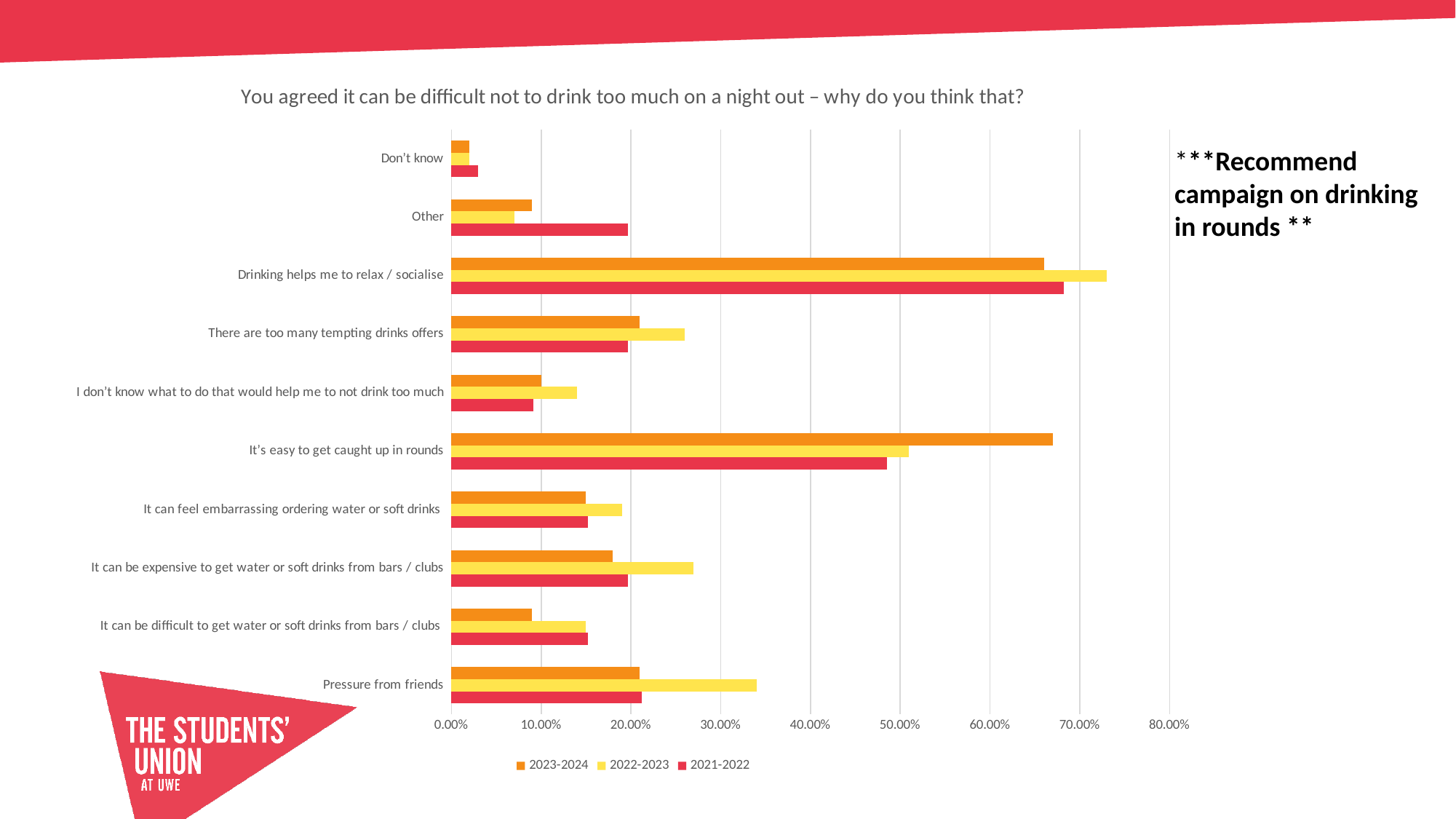
What kind of chart is shown on the slide? Bar chart How many series does the chart legend list? 3 How many categories (reasons) are plotted on the chart? 10 Is the 2023-2024 value for 'It's easy to get caught up in rounds' greater or less than 60%? greater Is the 2022-2023 value for 'Pressure from friends' greater or less than 30%? greater For 'It's easy to get caught up in rounds', which series has the larger value: 2023-2024 or 2021-2022? 2023-2024 Is the 2023-2024 value for 'It can be difficult to get water or soft drinks from bars / clubs' greater or less than 20%? less Which category has the highest value for the 2022-2023 series? Drinking helps me to relax / socialise Which category has the highest value for the 2021-2022 series? Drinking helps me to relax / socialise What is the title of the chart? You agreed it can be difficult not to drink too much on a night out – why do you think that? Which category has the lowest value for the 2023-2024 series? Don't know